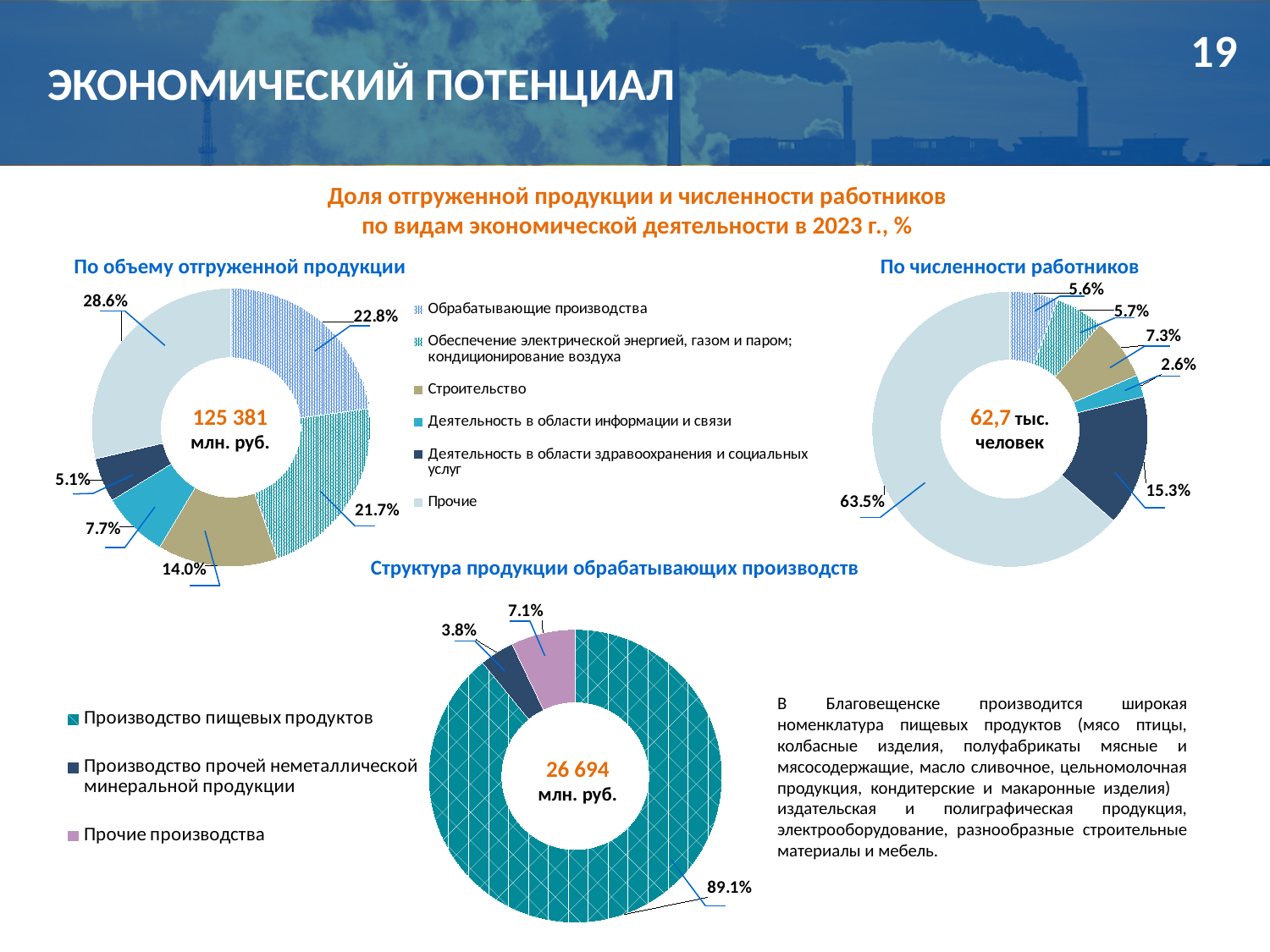
On the chart 'По численности работников', what is the difference in percentage points between 'Строительство' (7.3%) and 'Деятельность в области информации и связи' (2.6%)? 4.7 On the chart 'По объему отгруженной продукции', which category has the smallest share? Деятельность в области здравоохранения и социальных услуг On the chart 'По объему отгруженной продукции', which category has the largest share? Прочие On the chart 'По объему отгруженной продукции', what share is shown for 'Строительство'? 14.0% On the chart 'По численности работников', what share is shown for 'Деятельность в области здравоохранения и социальных услуг'? 15.3% On the chart 'По численности работников', what share is shown for 'Прочие'? 63.5% On the chart 'По объему отгруженной продукции', what is the total value shown in the centre of the donut? 125 381 млн. руб. On the chart 'Структура продукции обрабатывающих производств', which is larger: 'Прочие производства' or 'Производство прочей неметаллической минеральной продукции'? Прочие производства On the chart 'Структура продукции обрабатывающих производств', what share is shown for 'Производство пищевых продуктов'? 89.1% On the chart 'По численности работников', which category has the smallest share? Деятельность в области информации и связи On the chart 'По объему отгруженной продукции', what share is shown for 'Обрабатывающие производства'? 22.8% How many categories does the legend of the chart 'Структура продукции обрабатывающих производств' list? 3